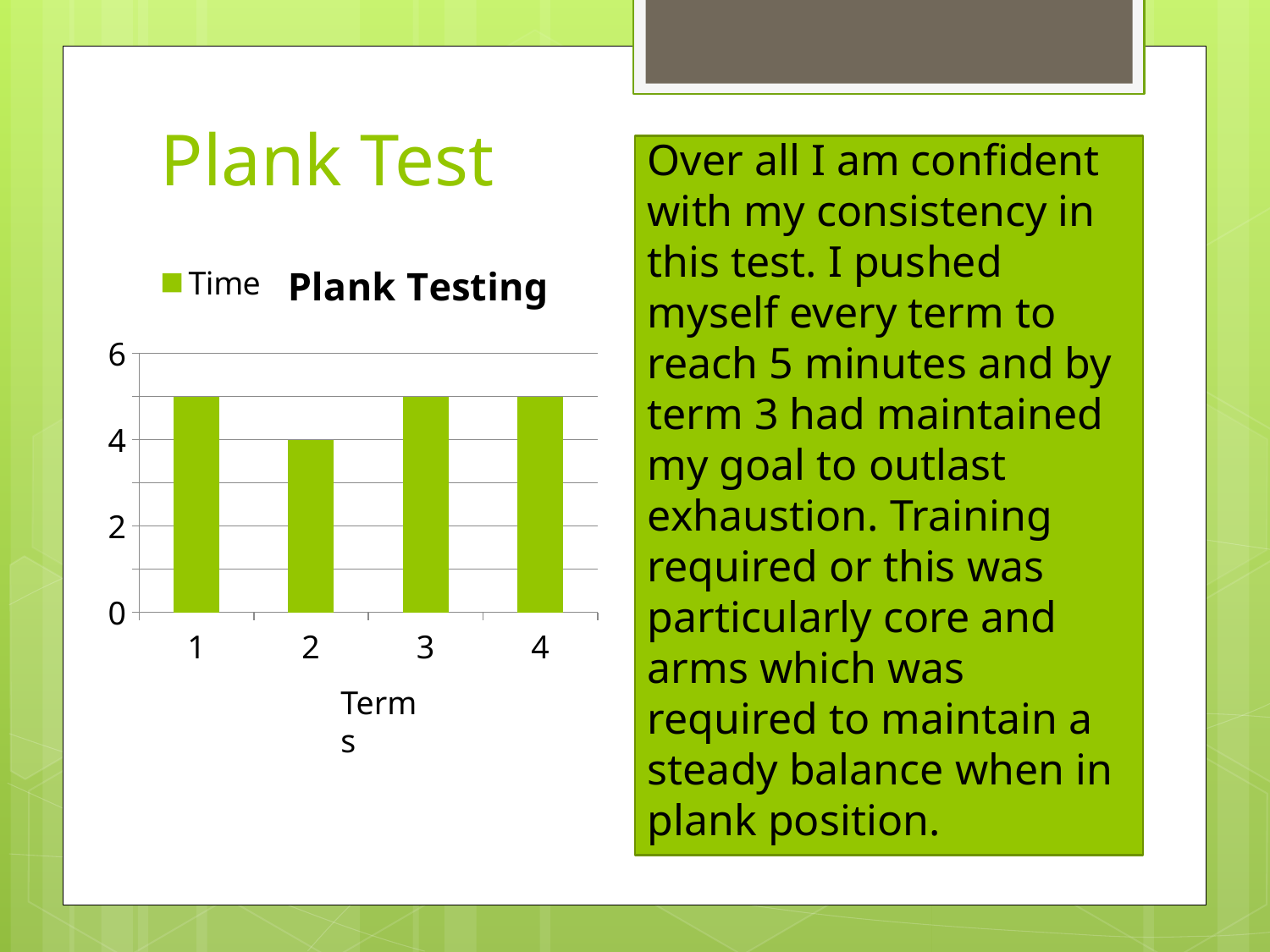
What is the value for term 2? 4 What type of chart is shown on the slide? bar chart Does the value rise or fall from term 1 to term 2? fall How many terms are plotted on the x axis? 4 Is the value for term 4 greater or less than 4? greater How many series does the legend list? 1 Is the value for term 3 greater or less than 6? less Which term has the lowest value? 2 What is the title of the chart? Plank Testing Is the value for term 1 greater or less than 4? greater What series name does the legend show? Time Which is larger, the value for term 1 or the value for term 2? term 1